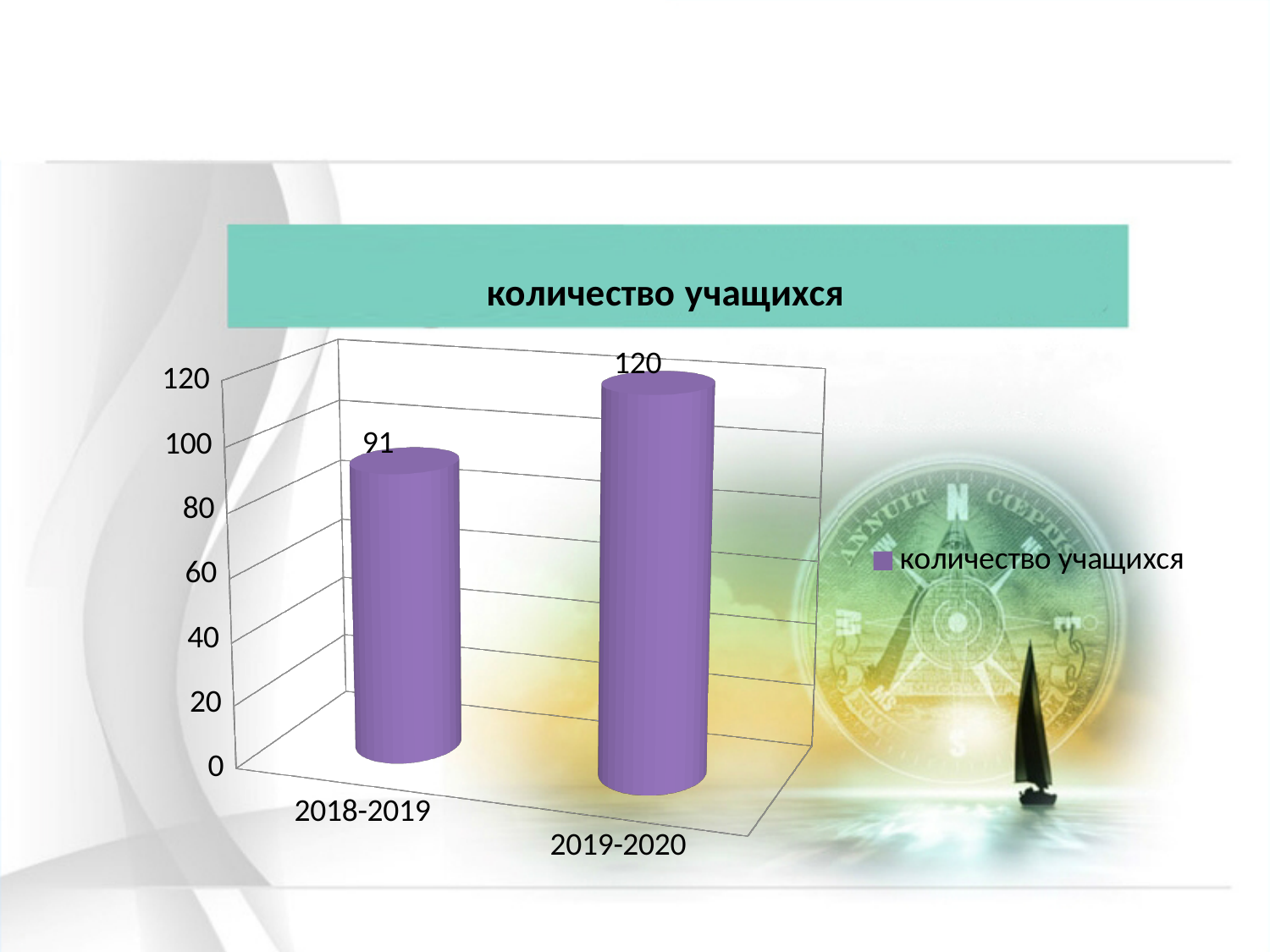
What is the difference between the values for 2019-2020 and 2018-2019? 29 How many categories are shown on the x axis? 2 Which category has the highest value? 2019-2020 What kind of chart is shown on the slide? bar chart What is the title of the chart? количество учащихся Is the value for 2018-2019 greater or less than 100? less Which category has the lowest value? 2018-2019 Which is larger, the value for 2018-2019 or the value for 2019-2020? 2019-2020 What is the value for 2019-2020? 120 How many series does the legend list? 1 What is the value for 2018-2019? 91 Do the values rise or fall from 2018-2019 to 2019-2020? rise